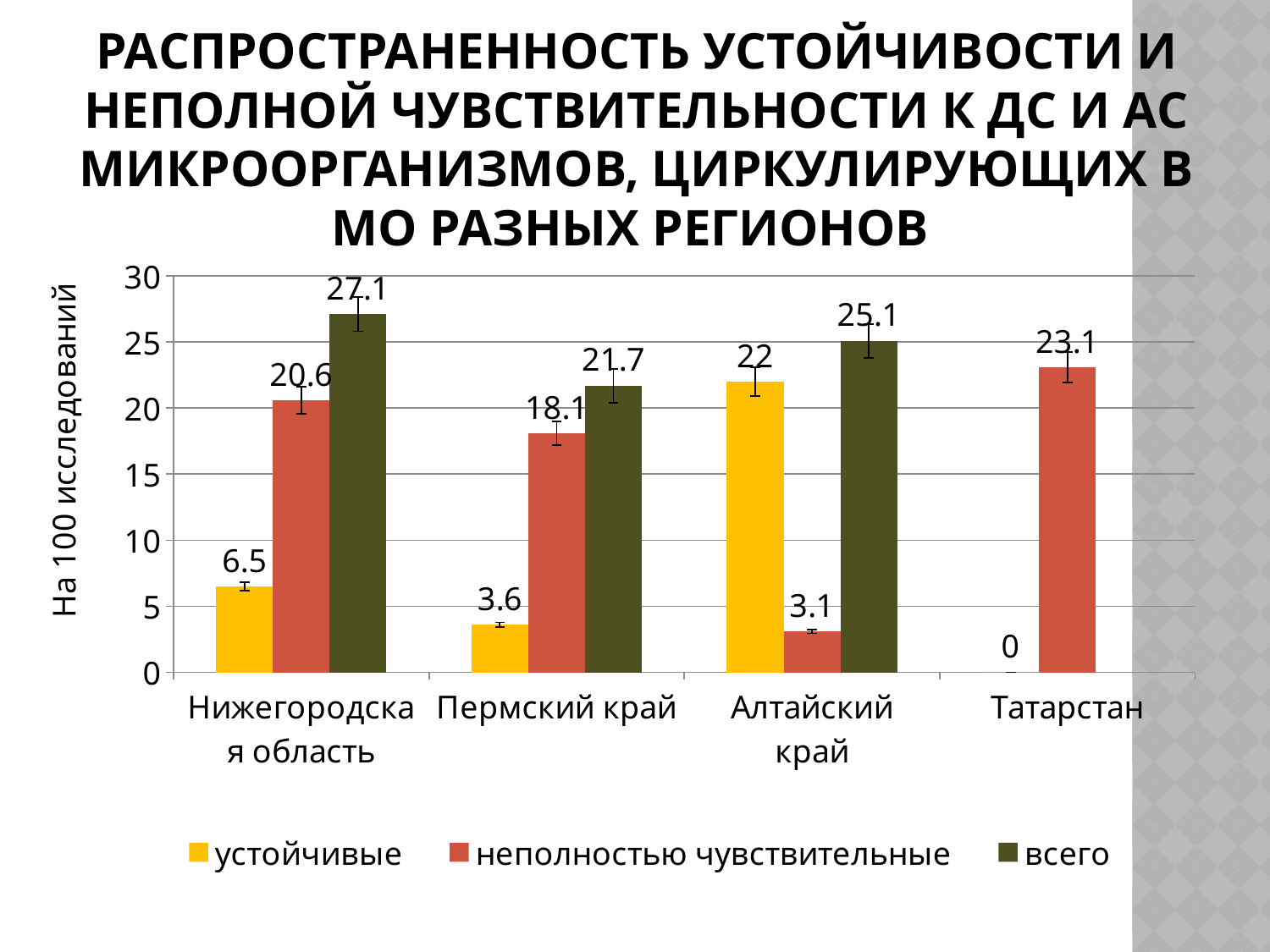
Which region has the lowest value in the 'неполностью чувствительные' series? Алтайский край What is the difference between the 'всего' values for Нижегородская область and Пермский край? 5.4 How many series does the legend list? 3 How many regions are shown on the x axis? 4 Which is larger: the 'устойчивые' value for Алтайский край or the 'неполностью чувствительные' value for Пермский край? устойчивые value for Алтайский край What is the value of the 'устойчивые' series for Нижегородская область? 6.5 What is the value of the 'всего' series for Алтайский край? 25.1 Which region has the highest value in the 'всего' series? Нижегородская область What kind of chart is shown on the slide? Bar chart What is the value of the 'устойчивые' series for Татарстан? 0 What is the value of the 'неполностью чувствительные' series for Татарстан? 23.1 What is the label of the vertical axis? На 100 исследований